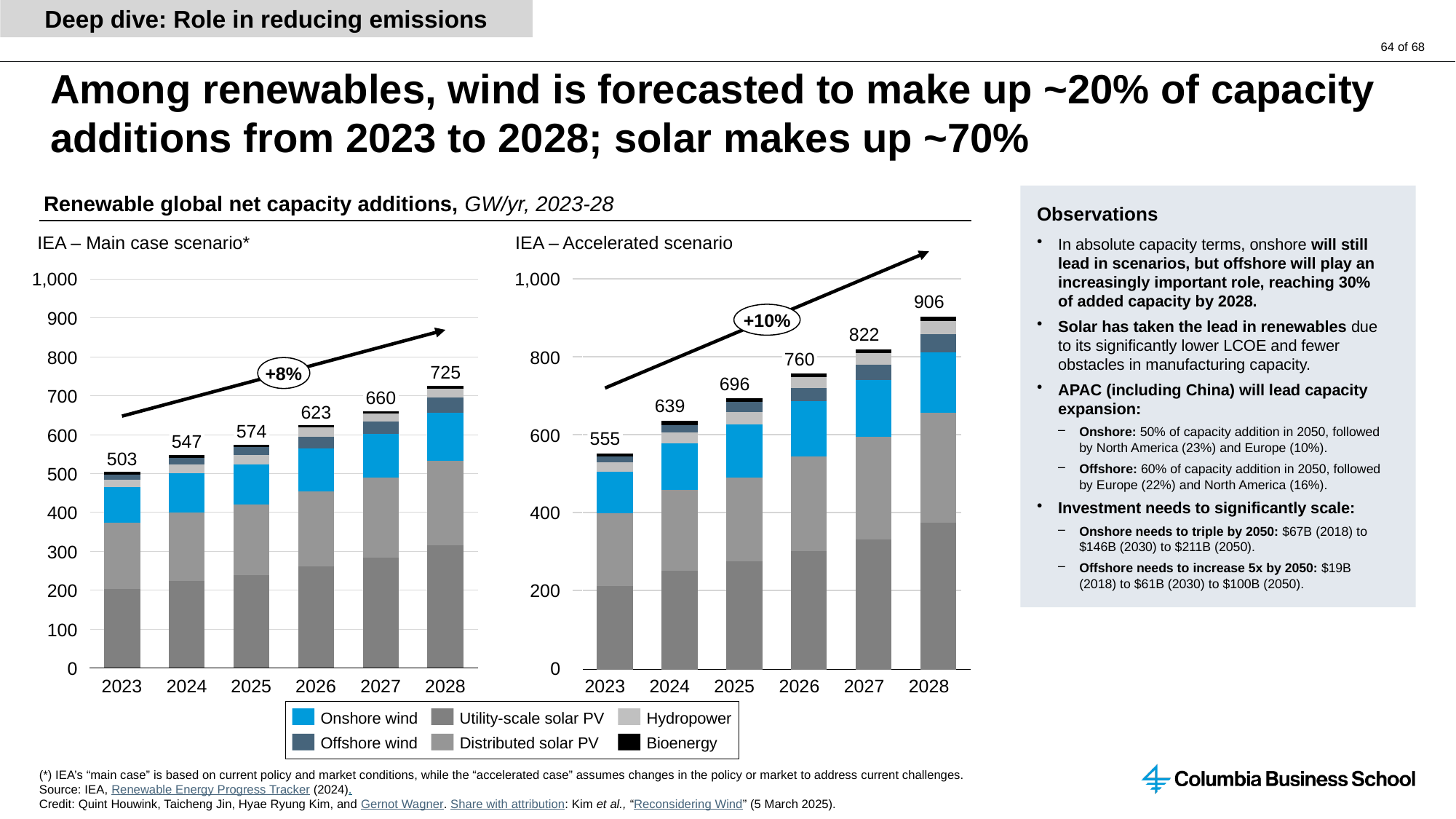
In the IEA – Accelerated scenario chart, what is the difference between the 2026 total and the 2025 total? 64 In the IEA – Main case scenario chart, which year has the highest total capacity addition? 2028 What kind of chart is the IEA – Main case scenario chart? Stacked bar chart Which is larger: the 2027 total in the IEA – Main case scenario chart or the 2025 total in the IEA – Accelerated scenario chart? 2025 total in the Accelerated scenario (696) In the IEA – Main case scenario chart, what is the difference between the 2028 total and the 2023 total? 222 How many series does the shared legend list for the two charts? 6 In the IEA – Accelerated scenario chart, which year has the lowest total capacity addition? 2023 How many years are shown on the x axis of the IEA – Accelerated scenario chart? 6 In the IEA – Main case scenario chart, is the total for 2026 greater or less than 600? greater In the IEA – Main case scenario chart, what is the total renewable net capacity addition shown for 2023? 503 In the IEA – Accelerated scenario chart, do the total capacity additions rise or fall from 2023 to 2028? Rise In the IEA – Accelerated scenario chart, what is the total renewable net capacity addition shown for 2028? 906